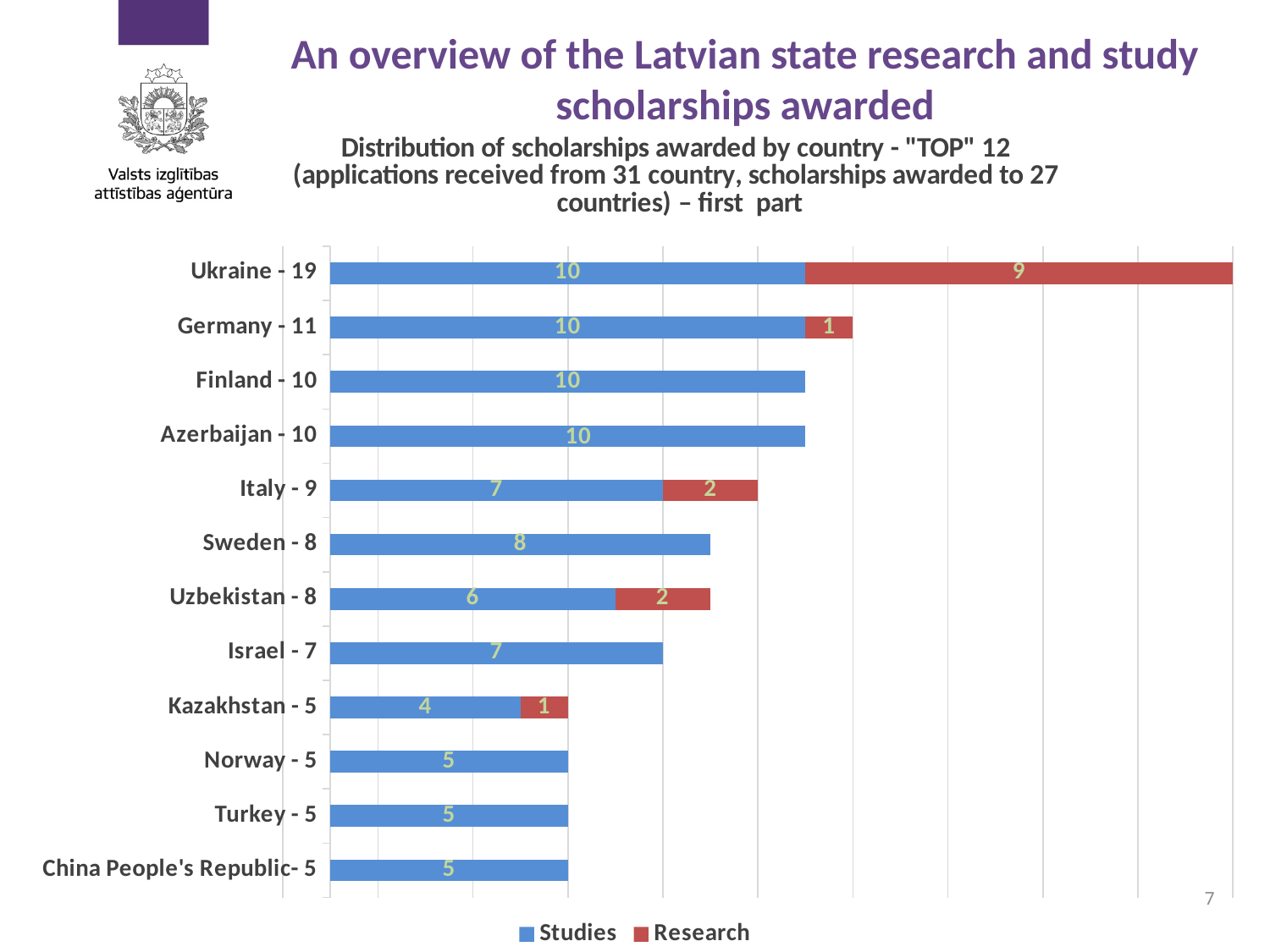
What is the Research value for Germany - 11? 1 What is the Research value for Italy - 9? 2 Which country has the highest Research value? Ukraine - 19 Which country has the lowest Studies value? Kazakhstan - 5 What is the Studies value for Uzbekistan - 8? 6 What is the total of the stacked bar for Kazakhstan - 5? 5 What is the Studies value for Ukraine - 19? 10 How many countries are shown in the chart? 12 Which is larger: the Research value for Ukraine - 19 or the Research value for Italy - 9? Ukraine - 19 How many series does the legend list? 2 What is the difference between the Studies value for Sweden - 8 and the Studies value for Israel - 7? 1 What kind of chart is shown on the slide? Stacked bar chart